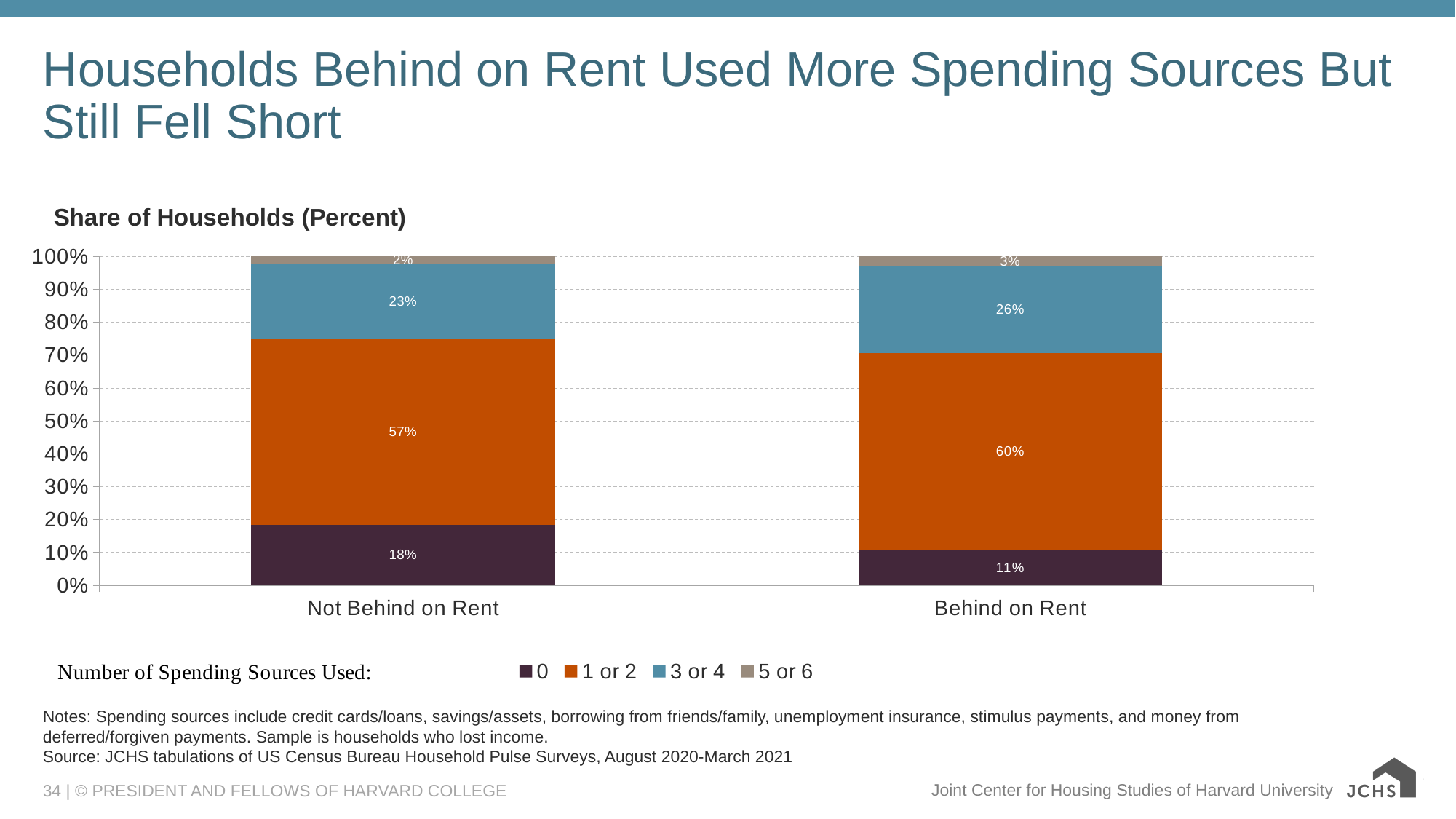
Which spending-source group makes up the largest share of households behind on rent? 1 or 2 How many series does the legend list? 4 Which spending-source group makes up the smallest share of households not behind on rent? 5 or 6 Which category has the larger share of households using 0 spending sources, Not Behind on Rent or Behind on Rent? Not Behind on Rent How many categories are shown on the x axis? 2 What share of households behind on rent used 3 or 4 spending sources? 26% What share of households not behind on rent used 1 or 2 spending sources? 57% What share of households not behind on rent used 5 or 6 spending sources? 2% What share of households behind on rent used 0 spending sources? 11% What is the difference between the share using 0 spending sources for Not Behind on Rent and Behind on Rent? 7% What kind of chart is shown on the slide? Stacked bar chart What is the difference between the share using 1 or 2 spending sources for Behind on Rent and Not Behind on Rent? 3%